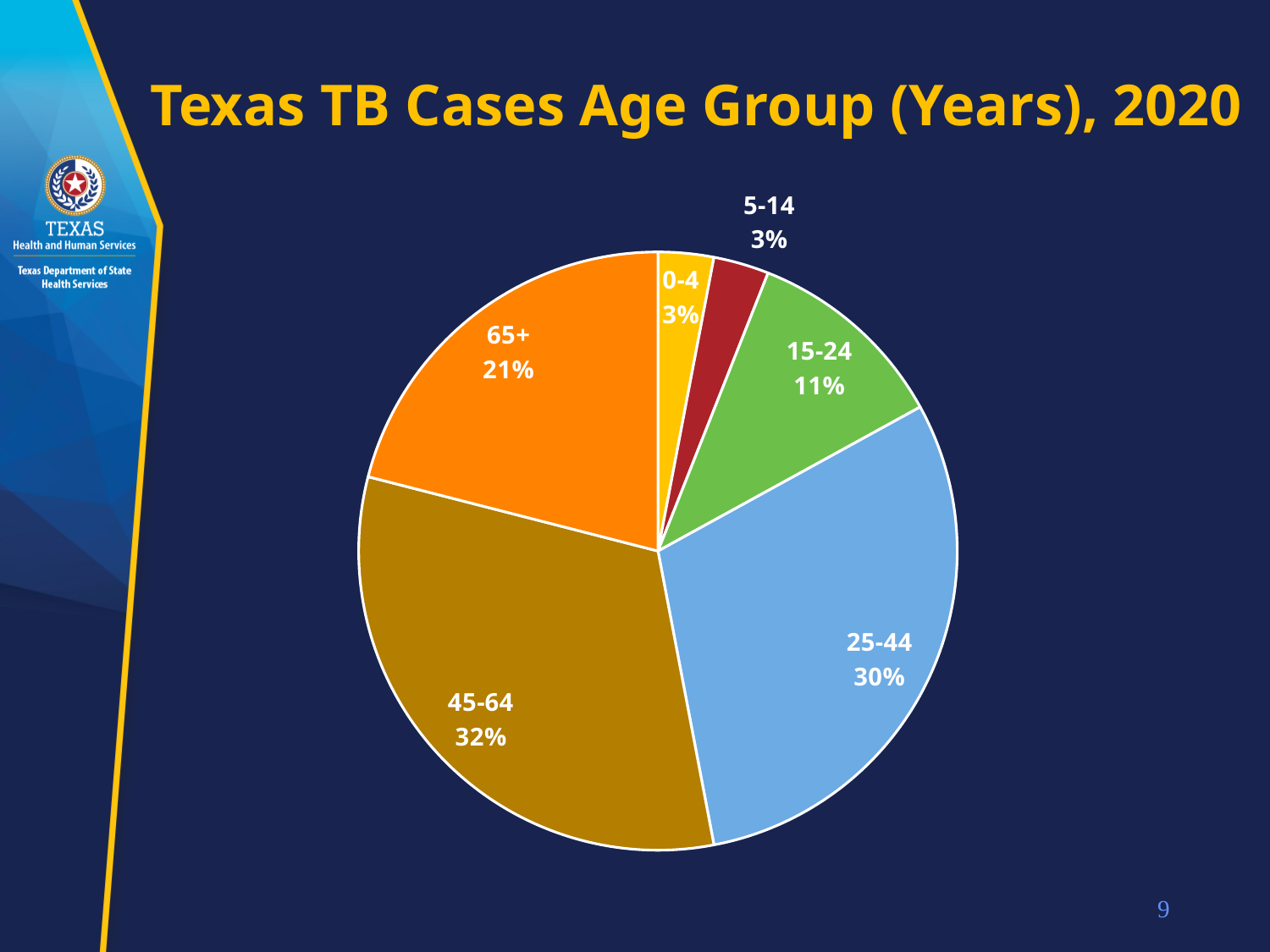
What is the combined share of the 0-4 and 5-14 age groups? 6% What percentage of cases were in the 65+ age group? 21% How many age groups are shown in the pie chart? 6 What percentage of cases were in the 25-44 age group? 30% What share of Texas TB cases in 2020 were in the 45-64 age group? 32% What colour is the slice for the 25-44 age group? light blue What type of chart is shown on the slide? pie chart What percentage of cases were in the 15-24 age group? 11% Which age group has a larger share, 25-44 or 15-24? 25-44 What is the difference in percentage points between the 45-64 and 65+ age groups? 11 Which age group has the largest share of TB cases? 45-64 What is the title of the chart? Texas TB Cases Age Group (Years), 2020